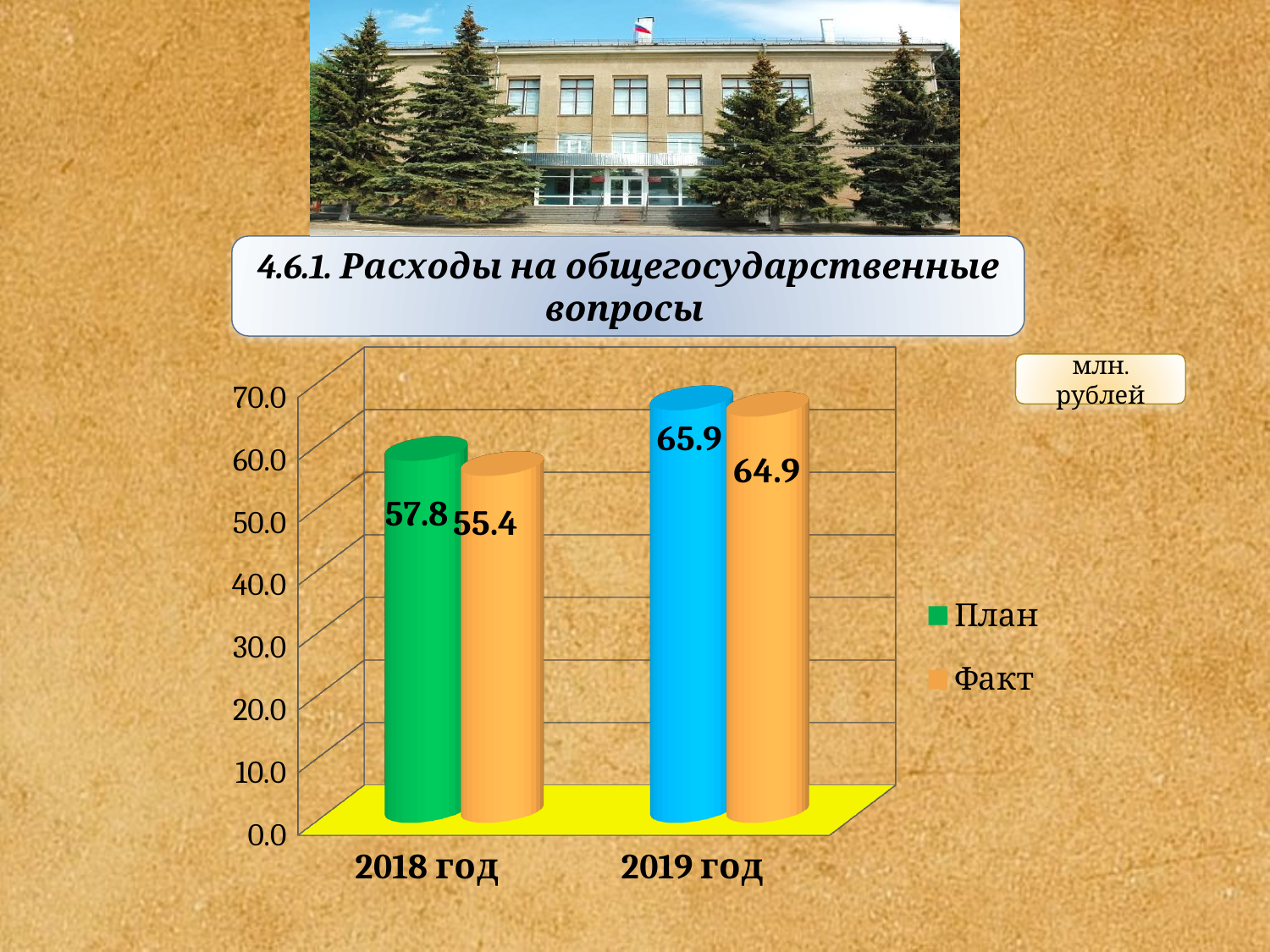
What is the Факт value for 2019 год? 64.9 Which is larger for 2019 год, План or Факт? План What kind of chart is shown on the slide? Bar chart What is the План value for 2018 год? 57.8 What is the Факт value for 2018 год? 55.4 Which bar has the lowest value on the chart? Факт for 2018 год What is the difference between the План values for 2019 год and 2018 год? 8.1 How many series does the legend list? 2 Which year has the higher Факт value? 2019 год What is the difference between План and Факт for 2018 год? 2.4 What is the План value for 2019 год? 65.9 What unit is indicated for the chart values? млн. рублей